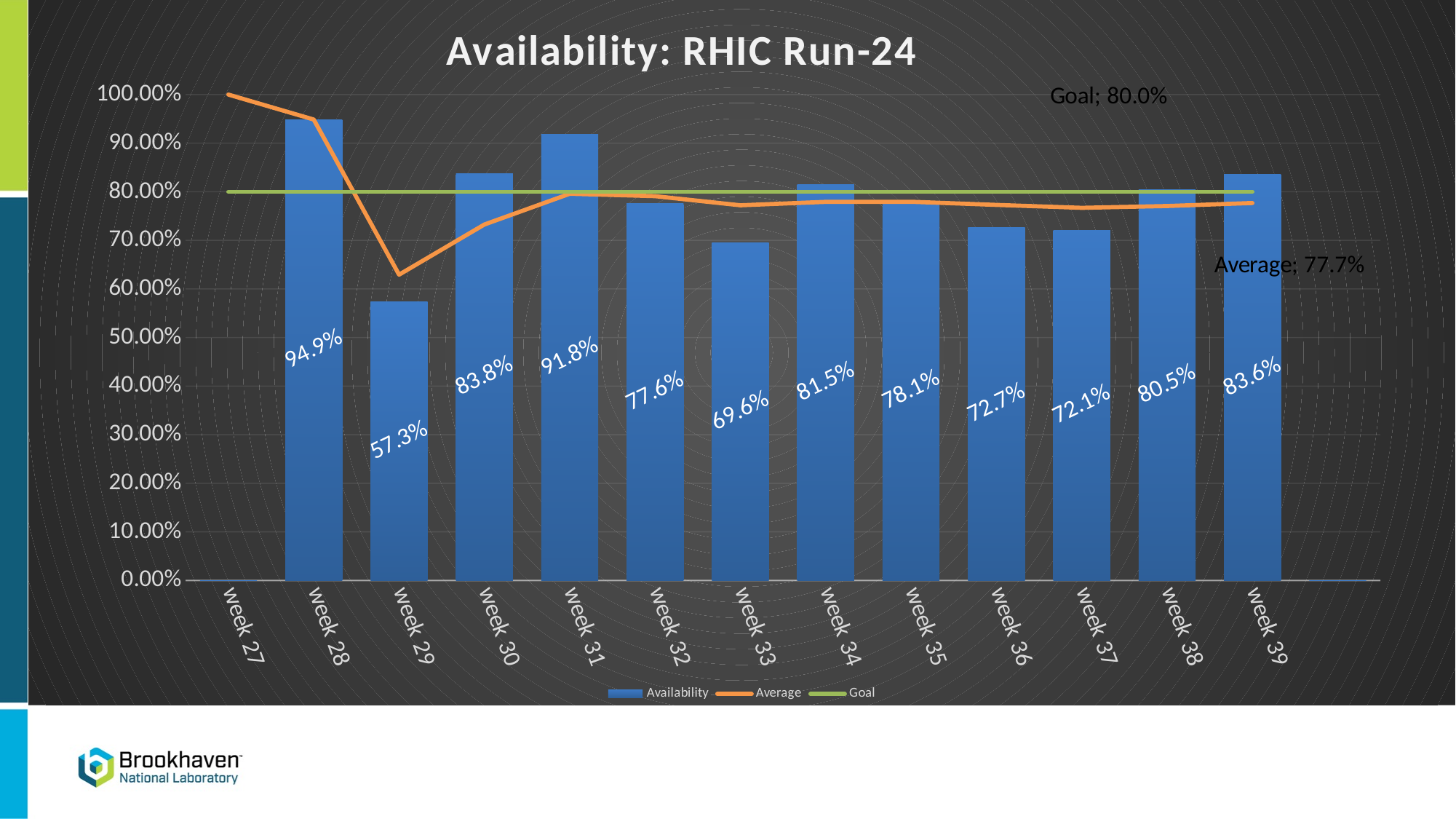
What is the availability for week 33? 69.6% Which week has the lowest availability? week 29 Is the availability for week 36 greater or less than 80.00%? less What is the difference in availability between week 28 and week 29? 37.6 percentage points What is the title of the chart? Availability: RHIC Run-24 Which has higher availability, week 31 or week 30? week 31 What value is shown for the Goal line? 80.0% How many weeks have an availability bar plotted? 12 What is the availability for week 38? 80.5% What is the availability for week 28? 94.9% Which week has the highest availability? week 28 How many series does the legend list? 3